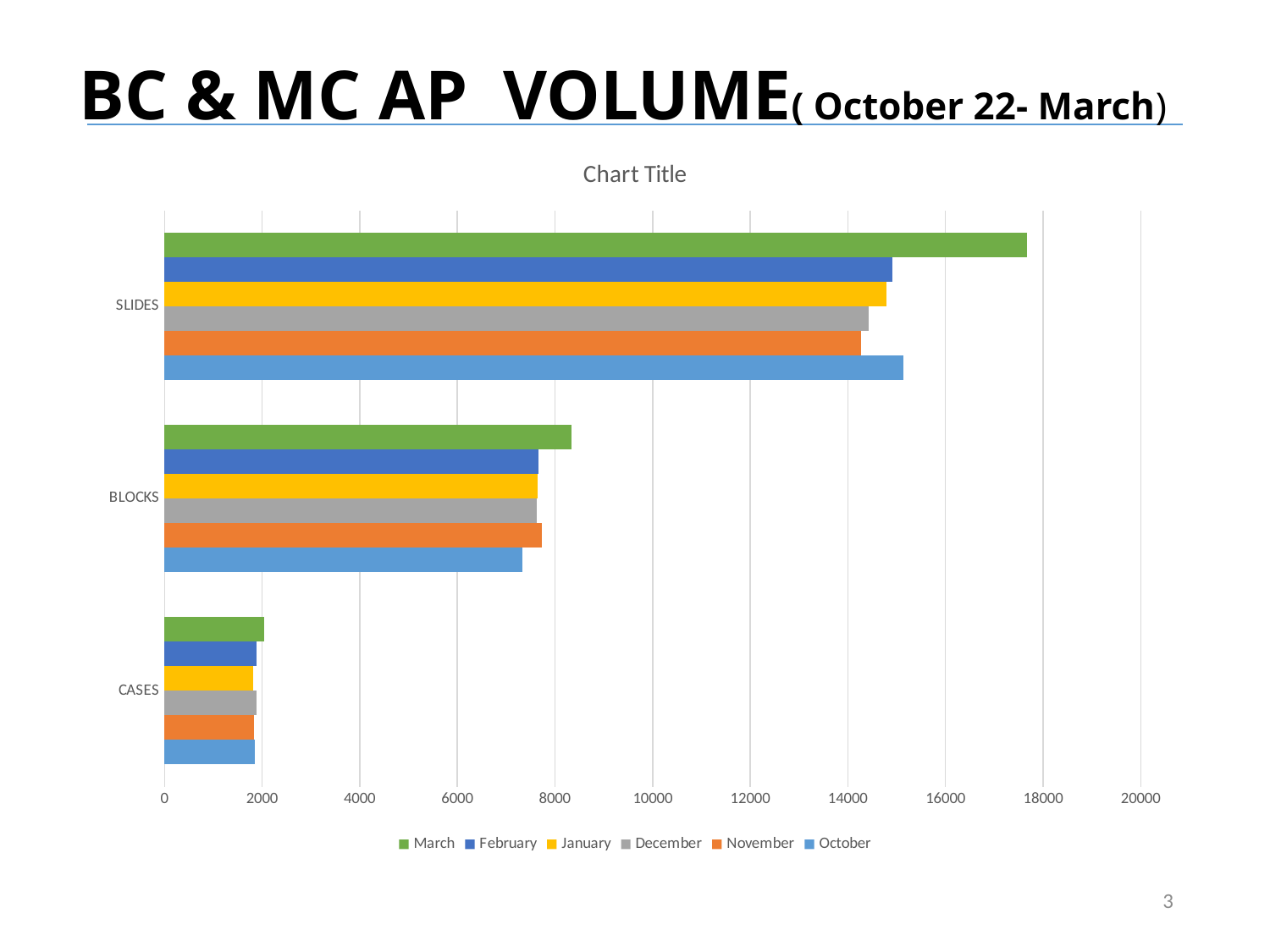
Which is larger for SLIDES: the March value or the October value? March How many series does the chart legend list? 6 Which category has the lowest values across all months? CASES What is the title shown above the chart? Chart Title Is the October value for BLOCKS greater or less than 8000? less For SLIDES, which month has the highest value? March What kind of chart is shown on the slide? bar chart Is the March value for CASES greater or less than 4000? less Is the October value for SLIDES greater or less than 14000? greater Which category has the highest March value? SLIDES How many categories are shown on the vertical axis of the chart? 3